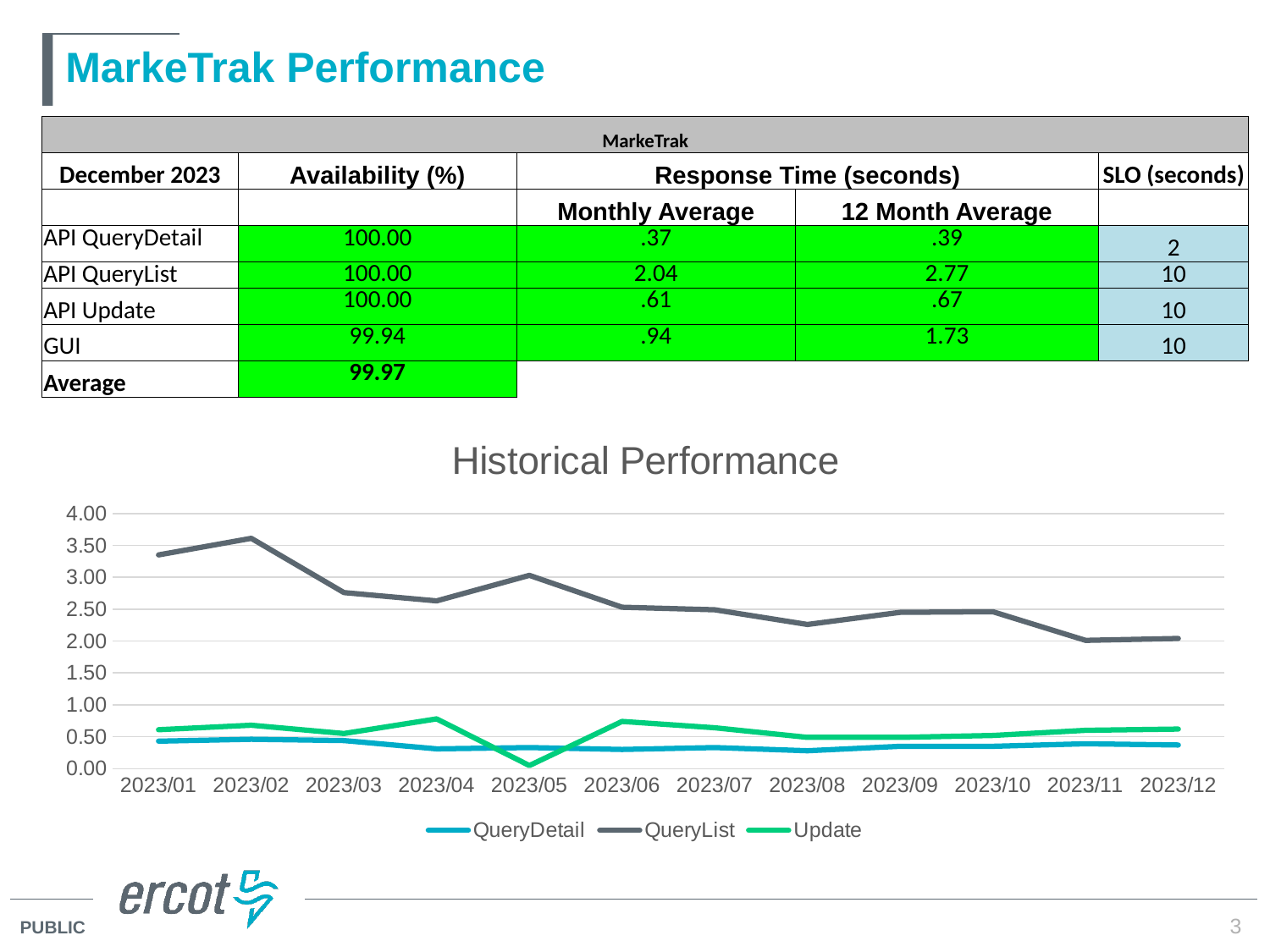
What kind of chart is the Historical Performance chart? line chart How many months are plotted along the x axis of the Historical Performance chart? 12 In the Historical Performance chart, is the value for QueryList in 2023/08 greater or less than 2.50? less In the Historical Performance chart, is the value for Update in 2023/05 greater or less than 0.50? less In the Historical Performance chart, which series has the highest values throughout the year? QueryList In the Historical Performance chart, which series is larger in 2023/06, QueryList or Update? QueryList How many series does the legend of the Historical Performance chart list? 3 In the Historical Performance chart, in which month does the QueryList series reach its highest value? 2023/02 In the Historical Performance chart, is the value for QueryList in 2023/01 greater or less than 3.00? greater In the Historical Performance chart, in which month does the Update series reach its lowest value? 2023/05 In the Historical Performance chart, does the QueryList series generally rise or fall from 2023/01 to 2023/12? fall